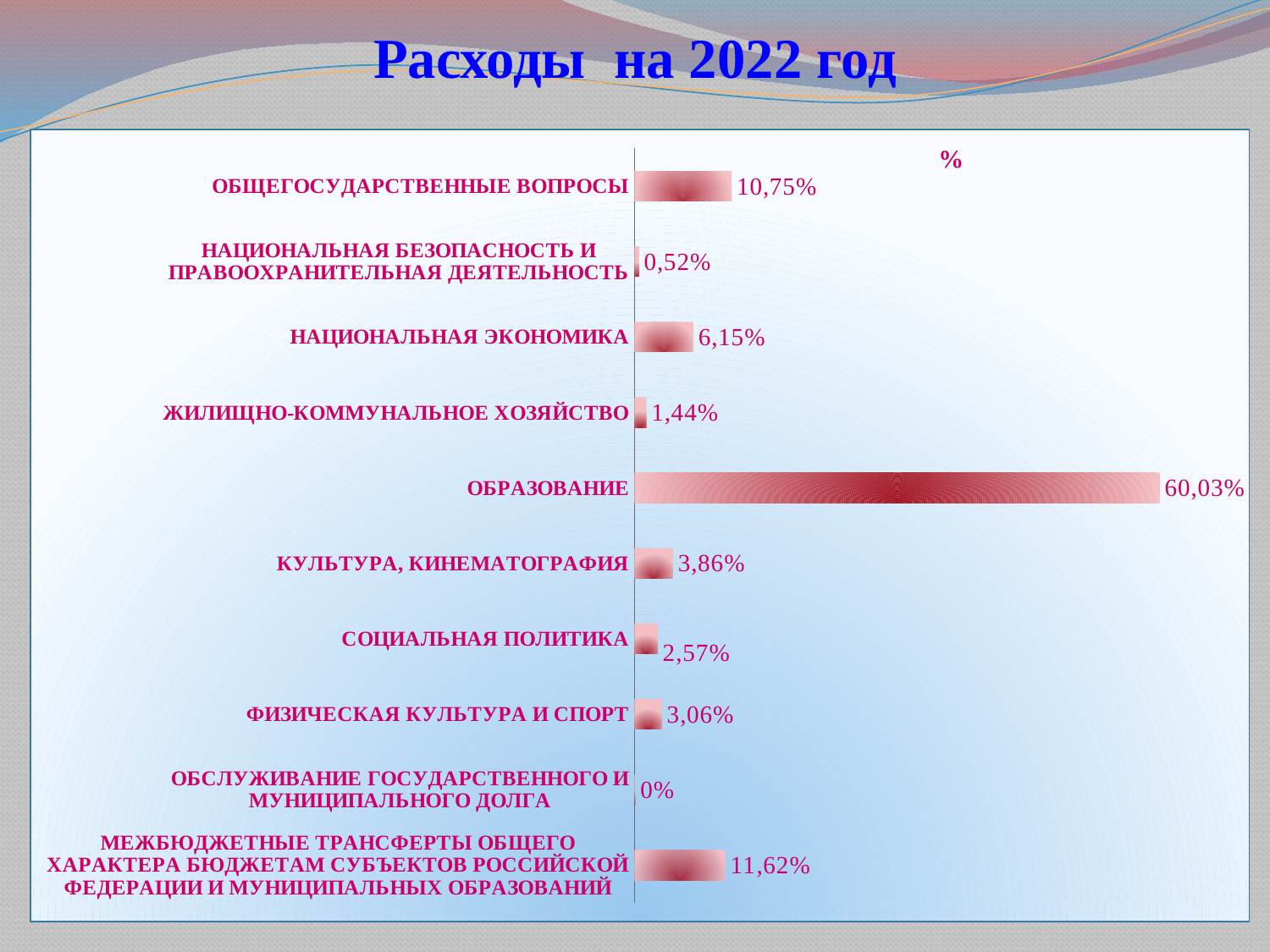
What is the value for ОБСЛУЖИВАНИЕ ГОСУДАРСТВЕННОГО И МУНИЦИПАЛЬНОГО ДОЛГА? 0% How many categories are shown in the chart? 10 What is the title of the slide? Расходы на 2022 год What is the value for НАЦИОНАЛЬНАЯ ЭКОНОМИКА? 6,15% Which category has the lowest value? ОБСЛУЖИВАНИЕ ГОСУДАРСТВЕННОГО И МУНИЦИПАЛЬНОГО ДОЛГА Which is larger: the value for МЕЖБЮДЖЕТНЫЕ ТРАНСФЕРТЫ ОБЩЕГО ХАРАКТЕРА БЮДЖЕТАМ СУБЪЕКТОВ РОССИЙСКОЙ ФЕДЕРАЦИИ И МУНИЦИПАЛЬНЫХ ОБРАЗОВАНИЙ or the value for ОБЩЕГОСУДАРСТВЕННЫЕ ВОПРОСЫ? МЕЖБЮДЖЕТНЫЕ ТРАНСФЕРТЫ ОБЩЕГО ХАРАКТЕРА БЮДЖЕТАМ СУБЪЕКТОВ РОССИЙСКОЙ ФЕДЕРАЦИИ И МУНИЦИПАЛЬНЫХ ОБРАЗОВАНИЙ What is the value for ОБРАЗОВАНИЕ? 60,03% What is the difference between the values for ОБРАЗОВАНИЕ and ОБЩЕГОСУДАРСТВЕННЫЕ ВОПРОСЫ? 49,28% What is the difference between the values for НАЦИОНАЛЬНАЯ ЭКОНОМИКА and КУЛЬТУРА, КИНЕМАТОГРАФИЯ? 2,29% What type of chart is shown on the slide? Bar chart Which category has the highest value? ОБРАЗОВАНИЕ What is the value for СОЦИАЛЬНАЯ ПОЛИТИКА? 2,57%